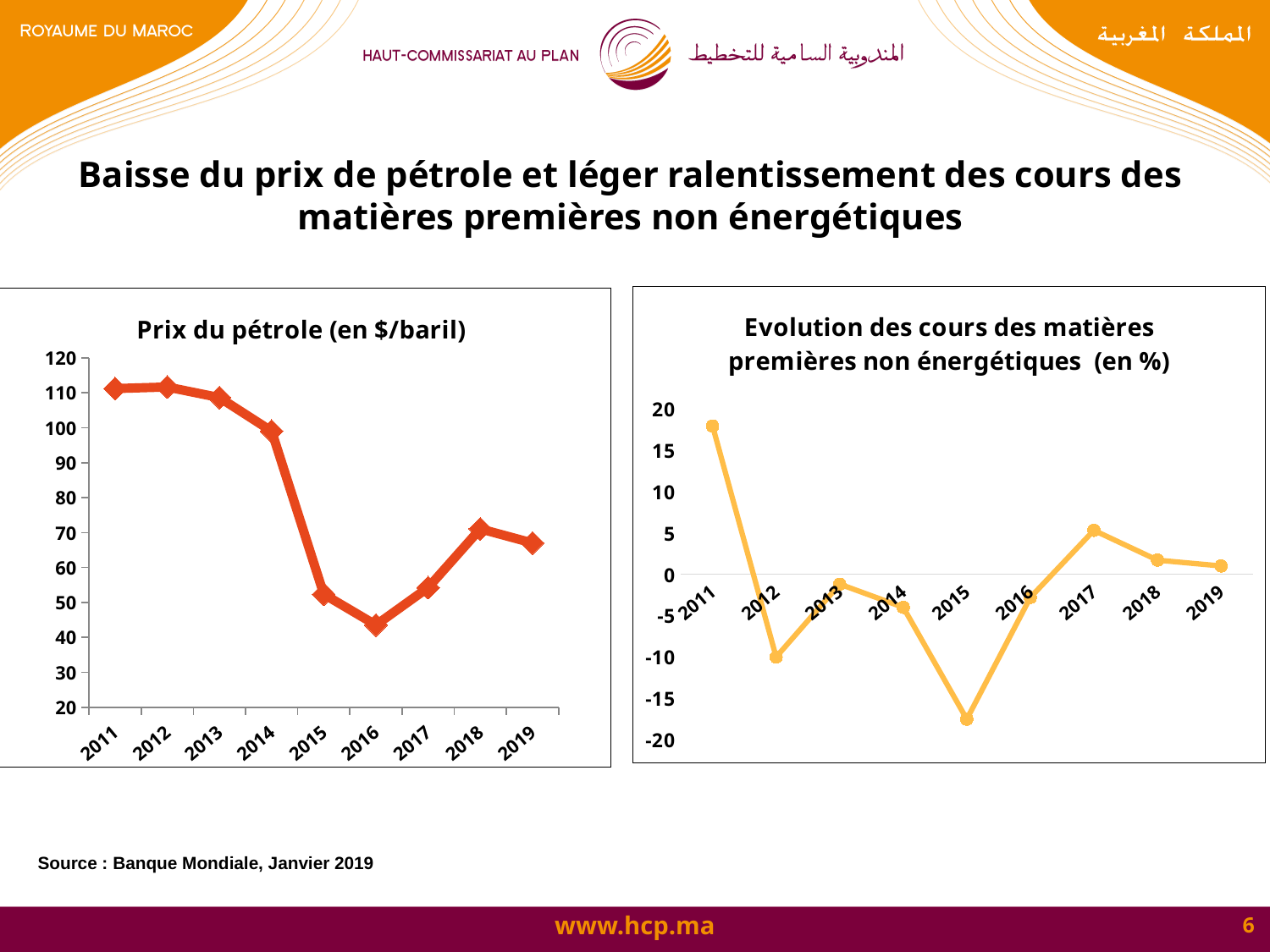
In the right chart 'Evolution des cours des matières premières non énergétiques (en %)', is the value for 2012 greater or less than -5? less In the left chart 'Prix du pétrole (en $/baril)', is the value for 2011 greater or less than 100? greater What source is cited for the charts on the slide? Banque Mondiale, Janvier 2019 In the left chart 'Prix du pétrole (en $/baril)', which is larger, the value for 2011 or the value for 2016? 2011 In the left chart 'Prix du pétrole (en $/baril)', how many years are plotted on the x axis? 9 What kind of chart is the left chart, 'Prix du pétrole (en $/baril)'? line chart In the left chart 'Prix du pétrole (en $/baril)', do the values rise or fall from 2013 to 2016? fall In the right chart 'Evolution des cours des matières premières non énergétiques (en %)', which year has the lowest value? 2015 In the right chart 'Evolution des cours des matières premières non énergétiques (en %)', is the value for 2015 greater or less than -15? less In the left chart 'Prix du pétrole (en $/baril)', which year has the lowest oil price? 2016 In the right chart 'Evolution des cours des matières premières non énergétiques (en %)', which year has the highest value? 2011